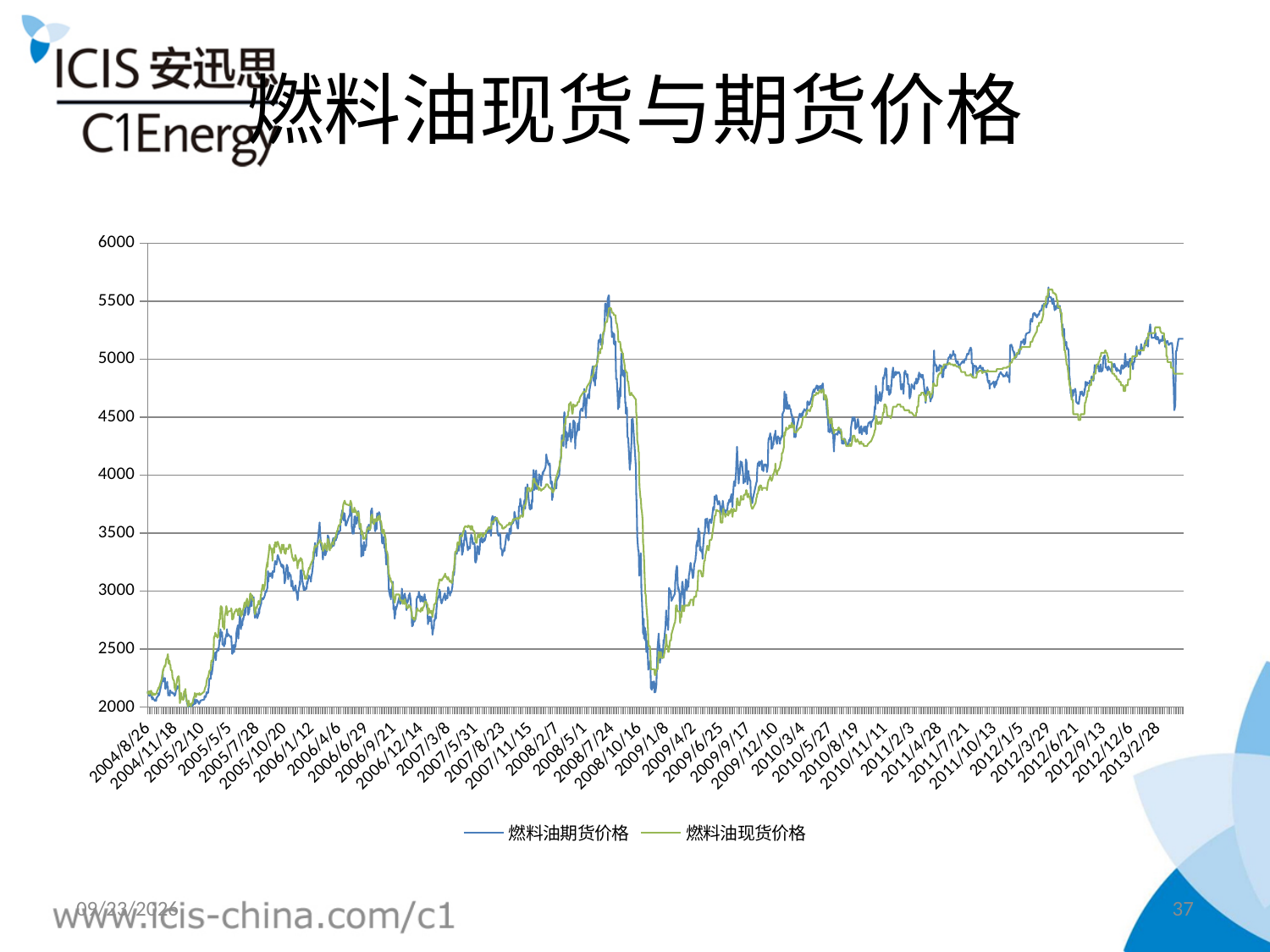
What is the title of the chart? 燃料油现货与期货价格 Is the value of 燃料油现货价格 at the start of the series (2004/8/26) greater or less than 2500? less Overall, do the prices rise or fall from 2004/8/26 to 2013/2/28? rise What kind of chart is shown on the slide? line chart Is the value of 燃料油期货价格 around 2008/7/24 greater or less than 5000? greater Is the value of 燃料油现货价格 around 2012/3/29 greater or less than 5000? greater How many series does the legend list? 2 Do the prices rise or fall between 2009/1/8 and 2012/3/29? rise Do the prices rise or fall between 2008/7/24 and 2009/1/8? fall Which series is drawn in blue according to the legend? 燃料油期货价格